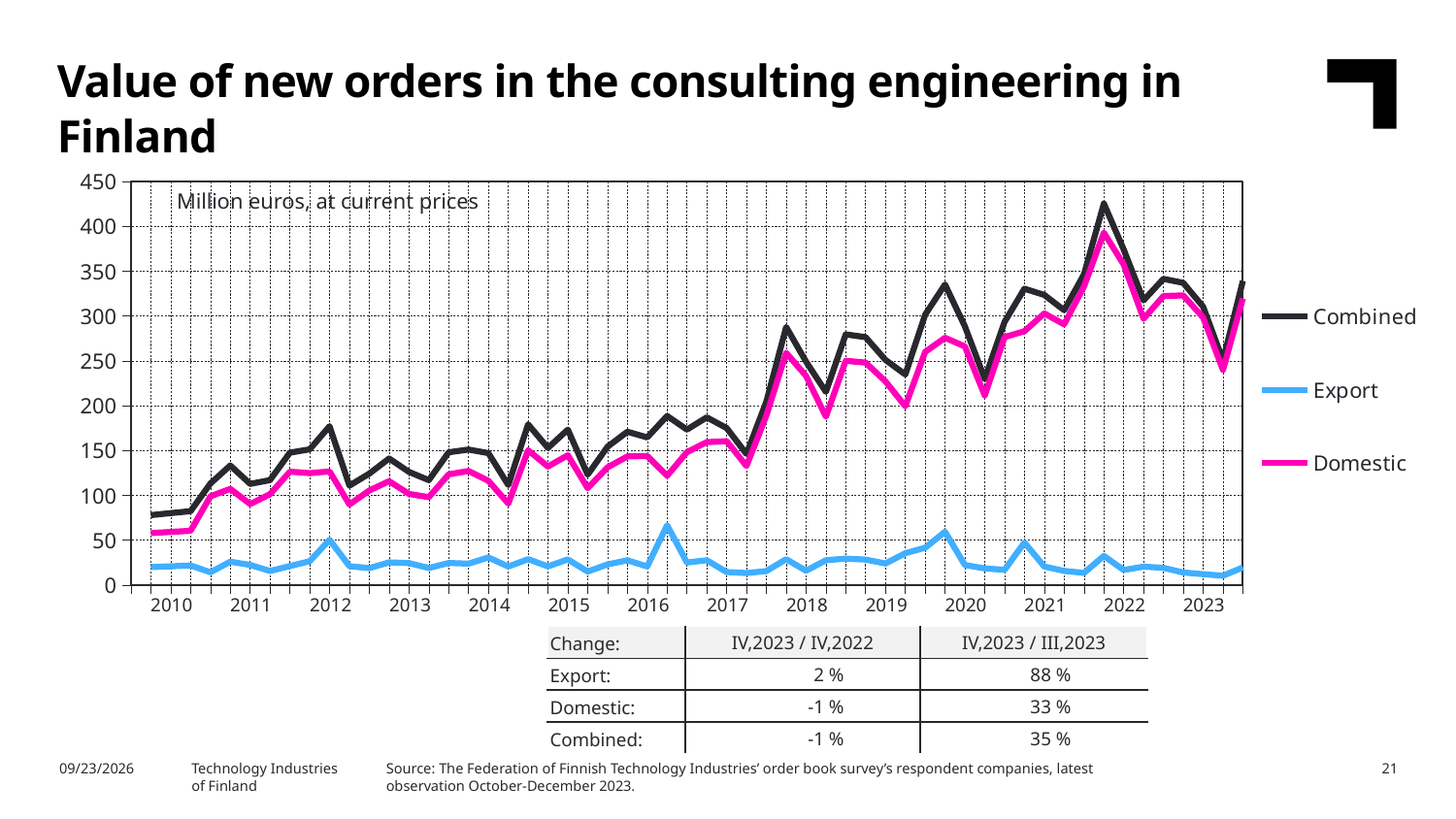
How many series does the legend list? 3 Overall, does the Combined series rise or fall from 2010 to 2023? rise Is the peak value of the Domestic series greater or less than 350? greater Which series has the highest values throughout the chart? Combined Is the Combined value at the start of 2010 greater or less than 100? less Is the highest value of the Export series greater or less than 100? less How many years are labelled on the x axis? 14 What kind of chart is shown on the slide? line chart Which series are listed in the legend? Combined, Export, Domestic Which series has the lowest values throughout the chart? Export What unit is stated in the chart's annotation? Million euros, at current prices